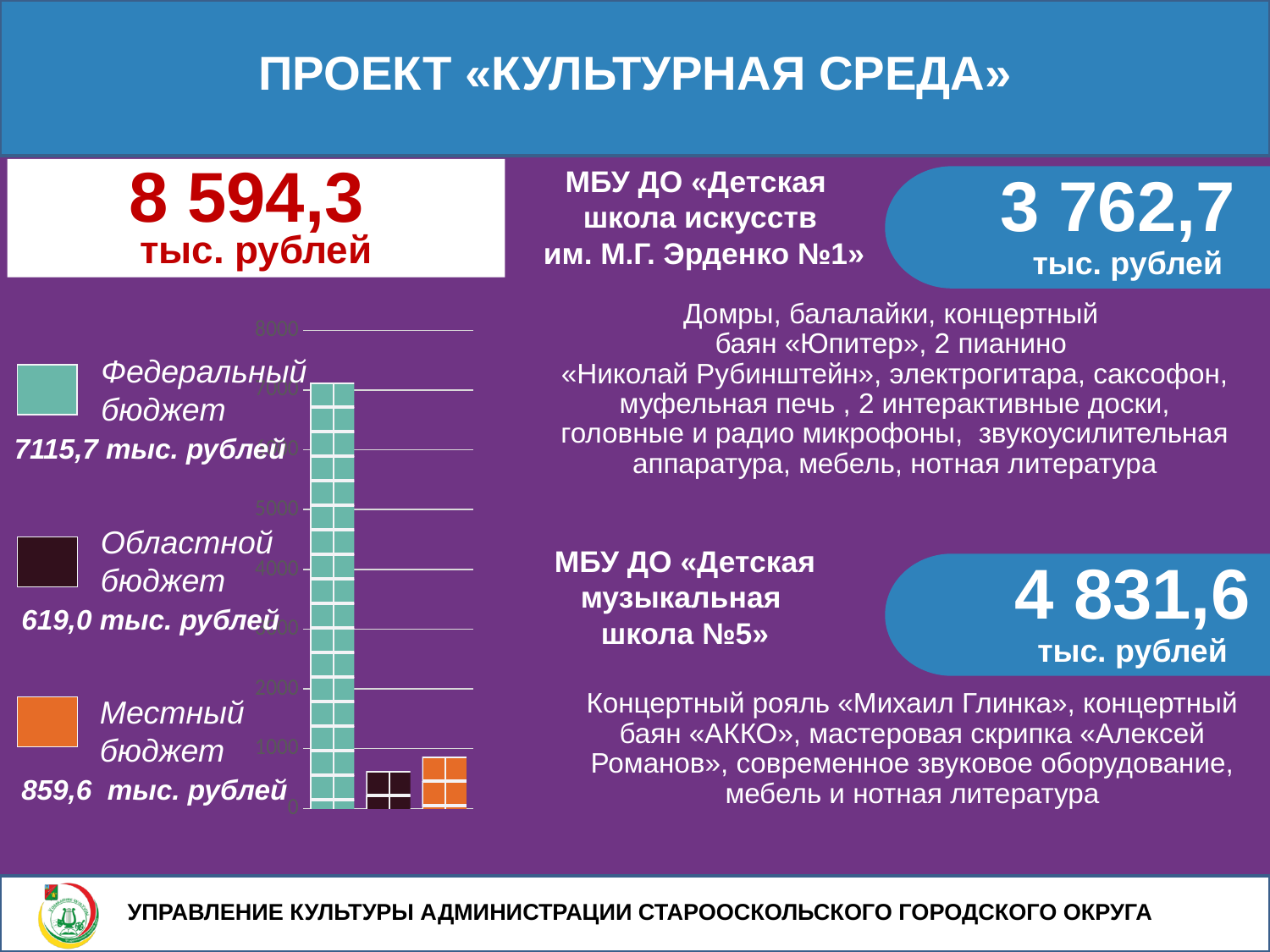
What is the difference between the Федеральный бюджет and Местный бюджет values in the bar chart? 6256,1 тыс. рублей What is the difference between the Местный бюджет and Областной бюджет values in the bar chart? 240,6 тыс. рублей Which budget category has the highest value in the bar chart? Федеральный бюджет Which budget category has the lowest value in the bar chart? Областной бюджет What is the value for Федеральный бюджет in the bar chart? 7115,7 тыс. рублей Is the value for Федеральный бюджет greater or less than 5000? greater Is the value for Местный бюджет greater or less than 1000? less What is the value for Местный бюджет in the bar chart? 859,6 тыс. рублей How many budget categories are shown in the bar chart? 3 Which is larger in the bar chart, Местный бюджет or Областной бюджет? Местный бюджет What kind of chart is shown on the slide? bar chart What is the value for Областной бюджет in the bar chart? 619,0 тыс. рублей